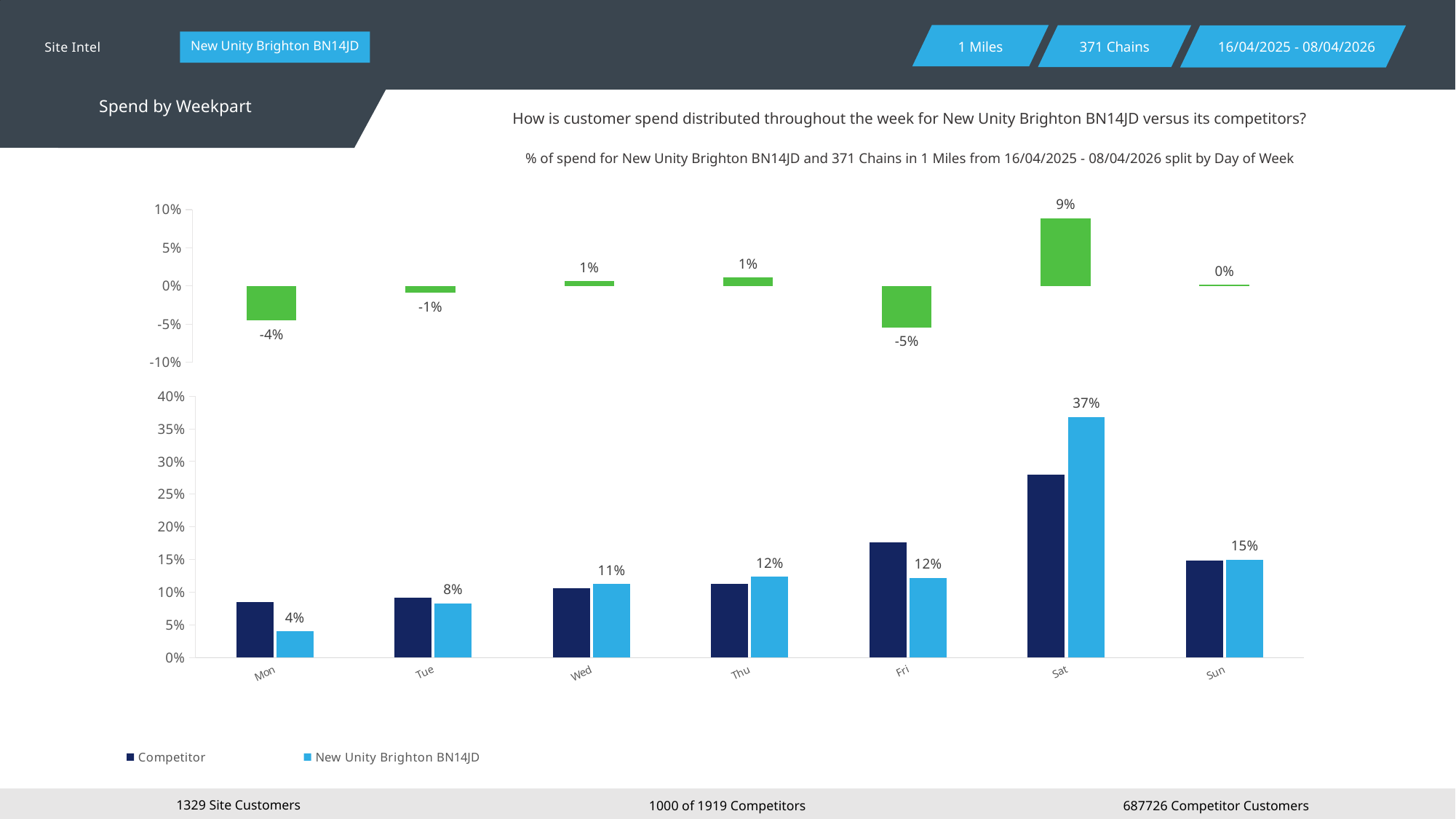
In the top chart, what is the value shown for Sat? 9% In the bottom chart, what is the value for New Unity Brighton BN14JD on Mon? 4% In the bottom chart, which day has the highest value for New Unity Brighton BN14JD? Sat In the bottom chart, what is the difference between the New Unity Brighton BN14JD values for Sat and Sun? 22% In the bottom chart, is the Competitor value for Sat greater or less than 25%? greater In the bottom chart, which is larger on Fri: the Competitor bar or the New Unity Brighton BN14JD bar? Competitor In the top chart, which day has the lowest value? Fri How many days of the week are shown on the x axis of the bottom chart? 7 How many series does the legend of the bottom chart list? 2 In the bottom chart, what is the value for New Unity Brighton BN14JD on Sat? 37% In the top chart, what is the value shown for Fri? -5% In the bottom chart, which day has the lowest value for New Unity Brighton BN14JD? Mon